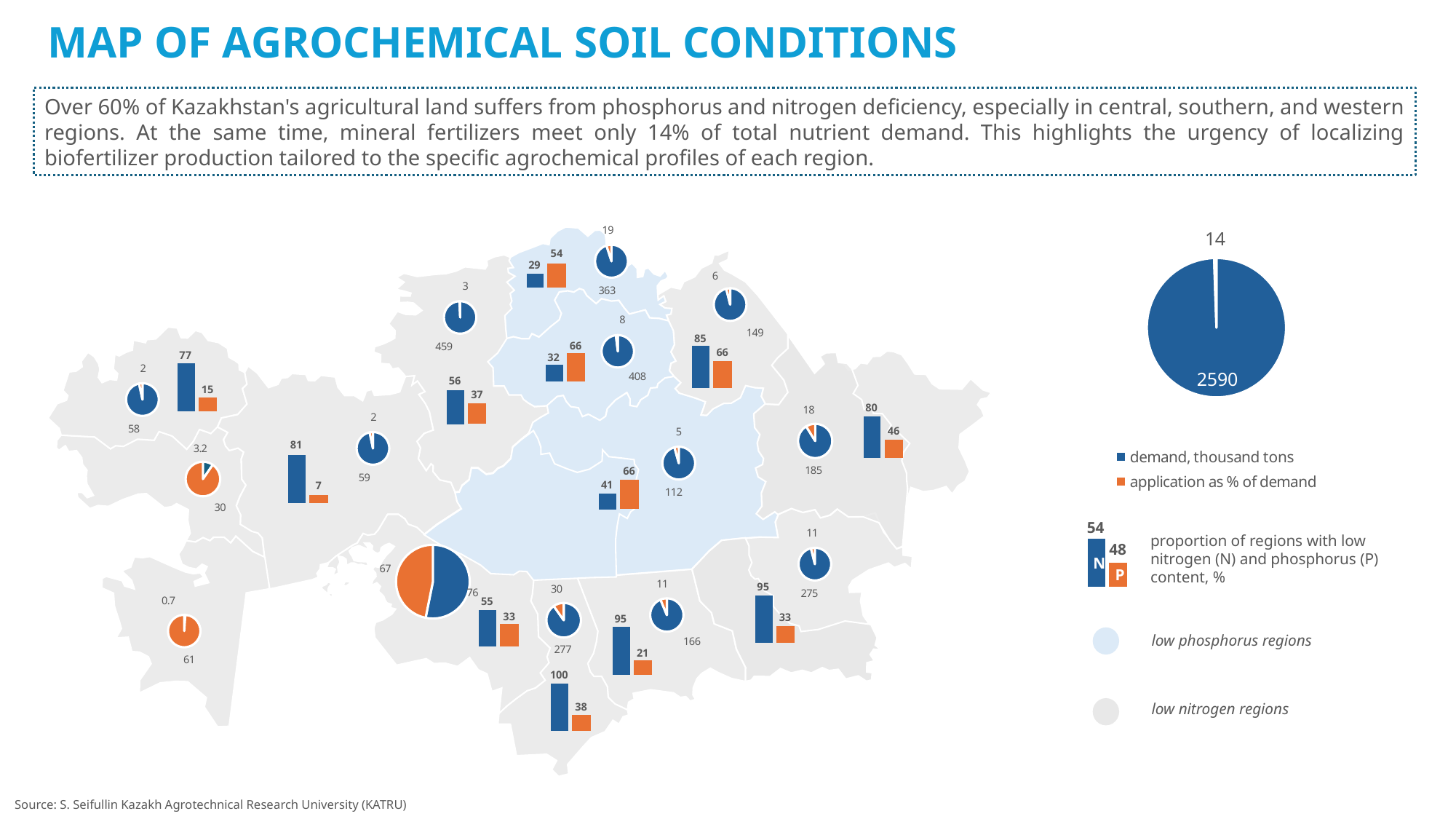
How many entries does the legend with 'demand, thousand tons' list? 2 What colour is used in the legend for 'application as % of demand'? orange Among the blue-and-orange bar pairs on the map, what is the highest value shown for N (blue bar)? 100 In the largest pie chart on the map (lower left of centre), what value is labelled next to the orange slice? 67 In the bar pair at the bottom centre of the map labelled 100 and 38, what is the difference between the N and P values? 62 Among the blue-and-orange bar pairs on the map, what is the lowest value shown for P (orange bar)? 7 What kind of chart is the large chart at the top right of the slide? pie chart In the largest pie chart on the map (lower left of centre), what value is labelled next to the blue slice? 76 In the bar pair at the top of the map labelled 29 and 54, which is larger, the N value or the P value? P In the large pie chart at the top right of the slide, what value is shown for demand, thousand tons? 2590 In the large pie chart at the top right of the slide, what value is shown for application as % of demand? 14 In the legend key for 'proportion of regions with low nitrogen (N) and phosphorus (P) content, %', what value is shown above the N bar? 54